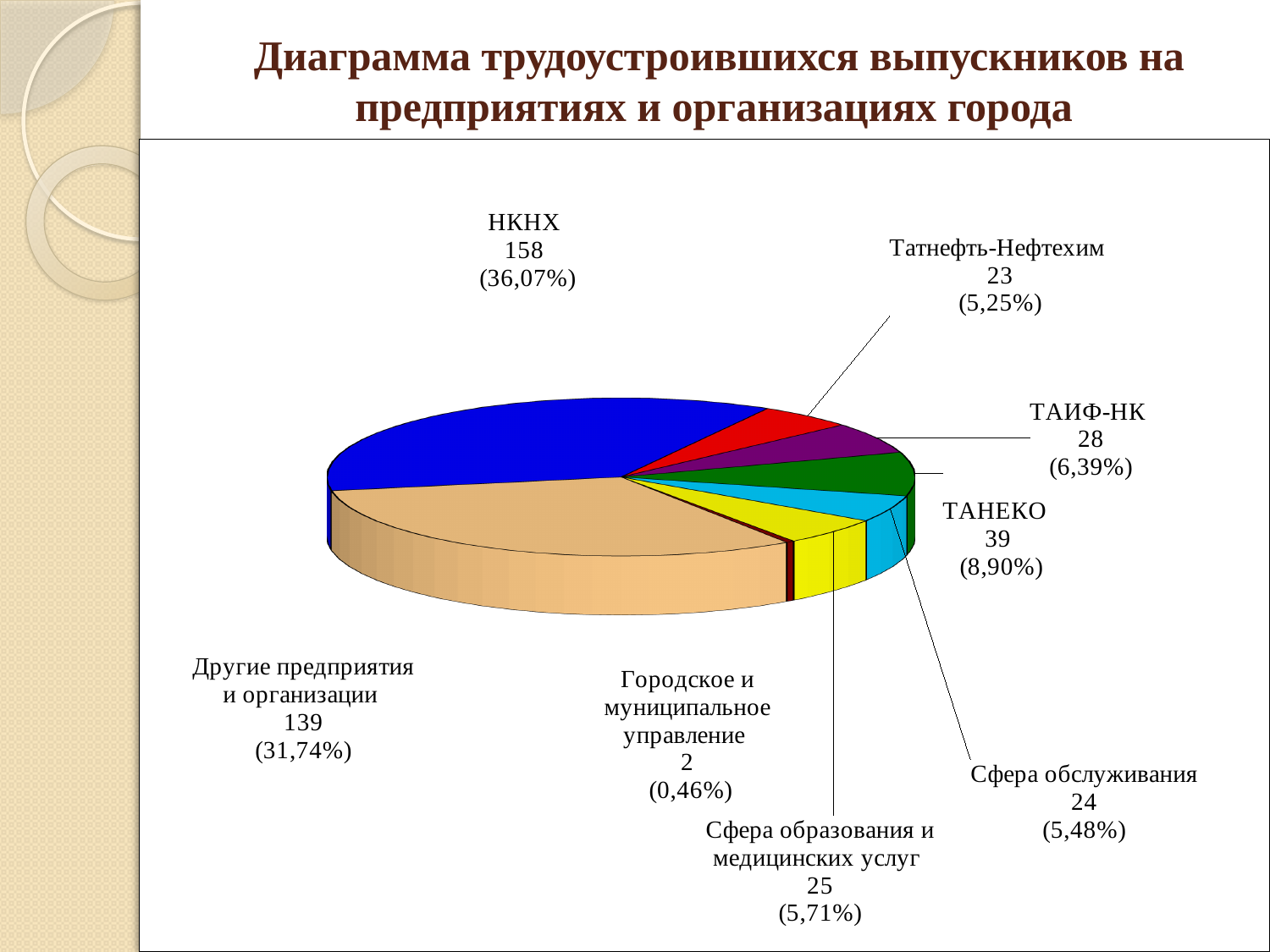
What is the title of the chart on the slide? Диаграмма трудоустроившихся выпускников на предприятиях и организациях города Which category has the smallest slice? Городское и муниципальное управление What share of the pie does Другие предприятия и организации have? 31,74% What is the value for НКНХ? 158 What is the difference between the values for НКНХ and Другие предприятия и организации? 19 Which is larger, the value for ТАИФ-НК or the value for Татнефть-Нефтехим? ТАИФ-НК How many categories (slices) does the pie chart have? 8 What is the value for ТАНЕКО? 39 What share of the pie does ТАИФ-НК have? 6,39% What is the value for Сфера образования и медицинских услуг? 25 What kind of chart is shown on the slide? pie chart Which category has the largest slice? НКНХ